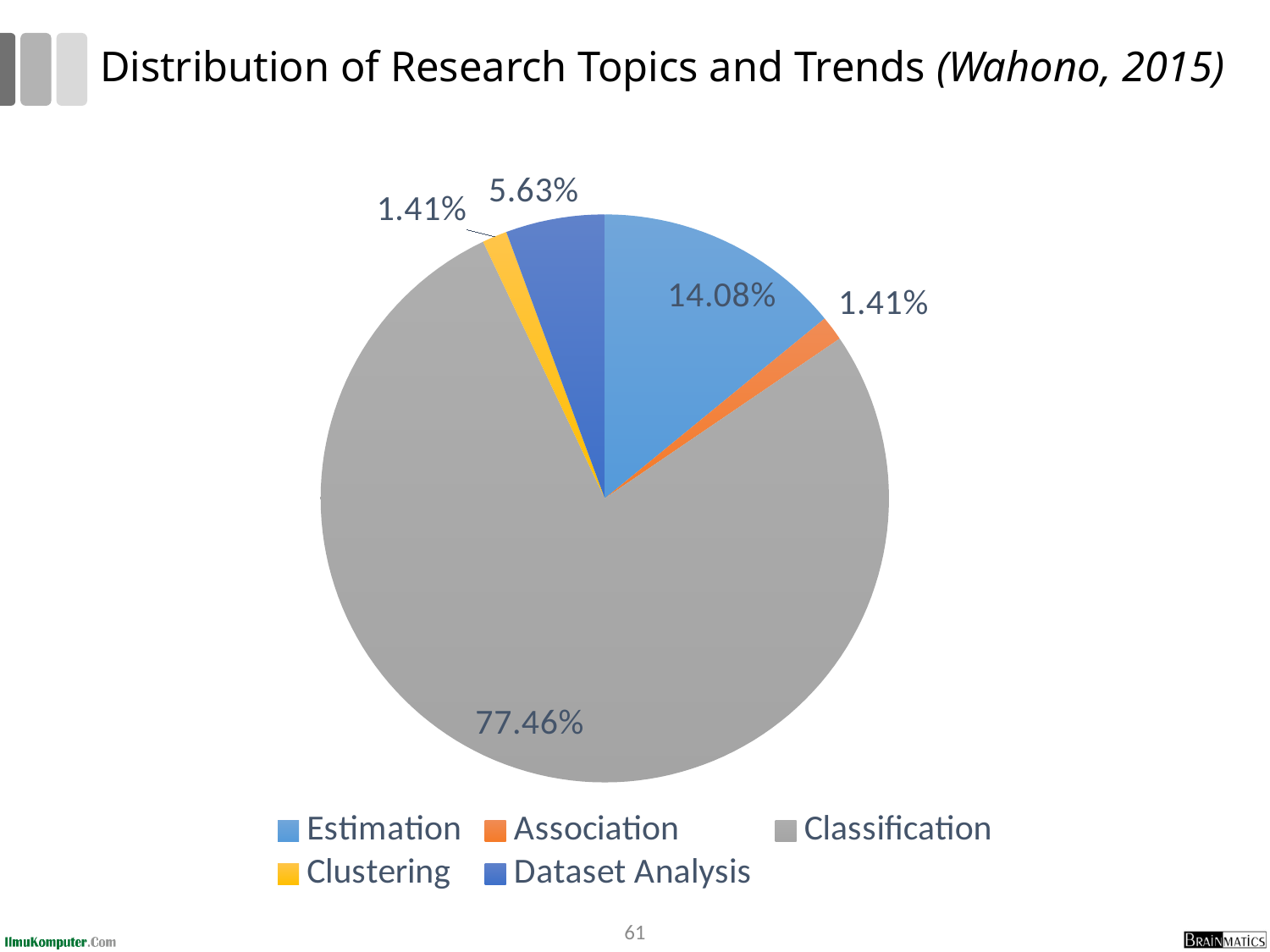
What share of the pie does Estimation have? 14.08% What share of the pie does Clustering have? 1.41% How many categories does the legend list? 5 What share of the pie does Classification have? 77.46% Which category has the largest slice of the pie? Classification What is the difference between the Classification share and the Estimation share? 63.38% What share of the pie does Dataset Analysis have? 5.63% What is the difference between the Estimation share and the Dataset Analysis share? 8.45% Which is larger, the slice for Estimation or the slice for Dataset Analysis? Estimation What share of the pie does Association have? 1.41% What is the title of the slide containing the chart? Distribution of Research Topics and Trends (Wahono, 2015) What kind of chart is shown on the slide? pie chart